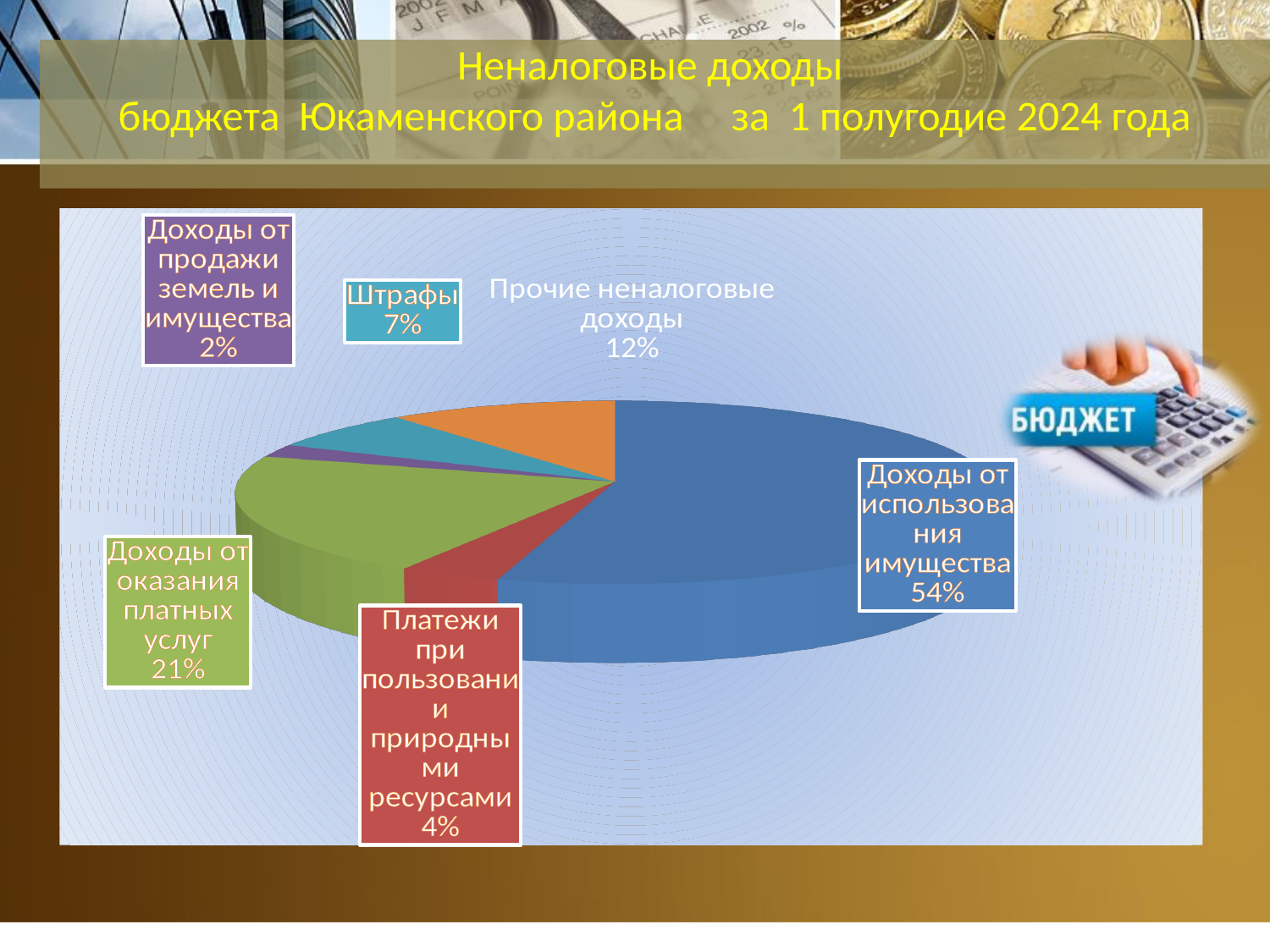
How many categories are shown in the pie chart? 6 What share is shown for «Прочие неналоговые доходы»? 12% What type of chart is shown on the slide? Pie chart Which category has the smallest share of the pie? Доходы от продажи земель и имущества Which is larger: the share for «Штрафы» or the share for «Прочие неналоговые доходы»? Прочие неналоговые доходы What share of non-tax revenues comes from «Доходы от использования имущества»? 54% What is the difference in percentage points between «Доходы от использования имущества» and «Доходы от оказания платных услуг»? 33 What period does the chart title say the data covers? 1 полугодие 2024 года What share is shown for «Доходы от оказания платных услуг»? 21% What share is shown for «Платежи при пользовании природными ресурсами»? 4% What percentage is labelled for «Штрафы»? 7% Which category has the largest share of the pie? Доходы от использования имущества